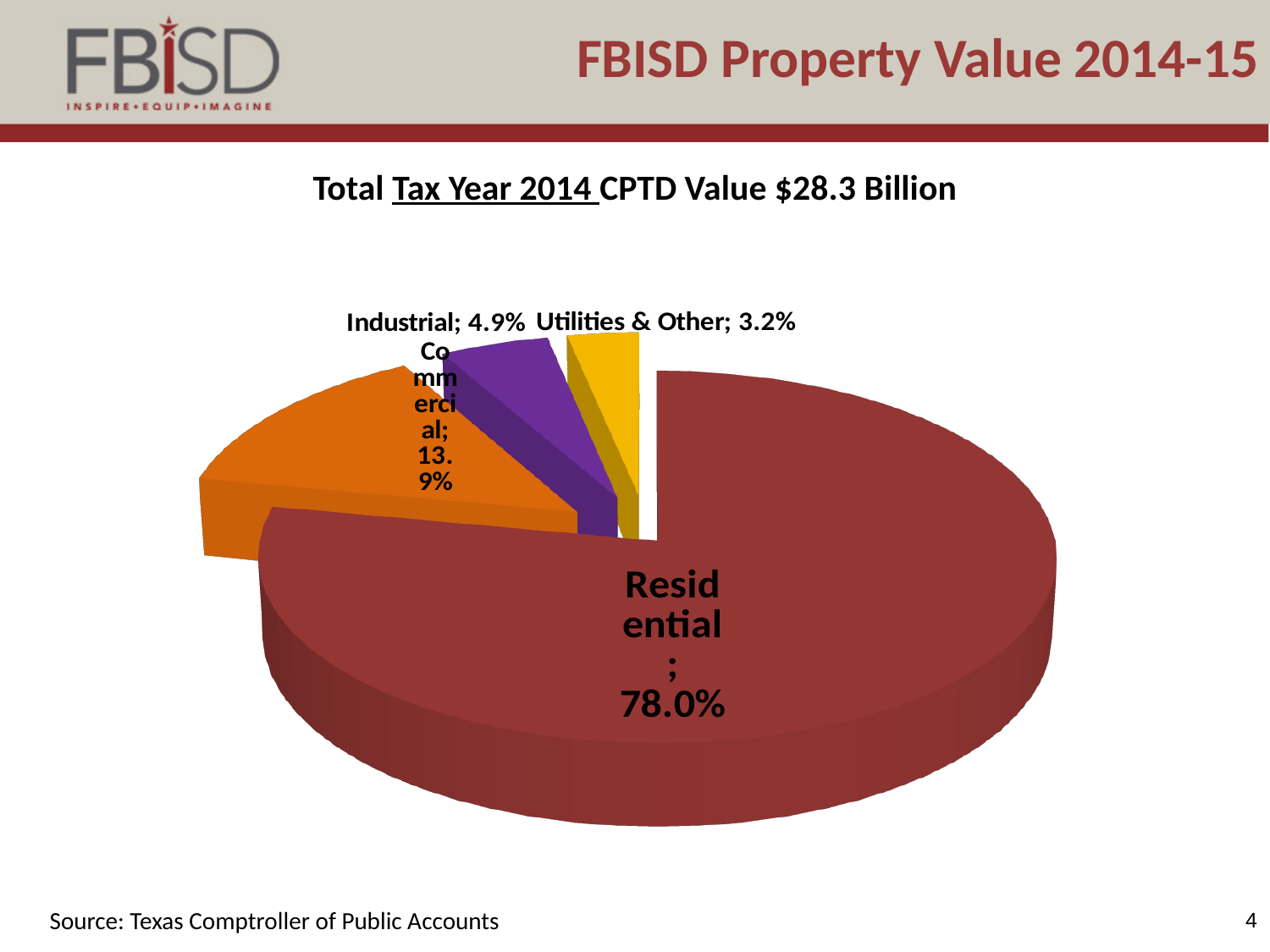
What share of the pie does Utilities & Other represent? 3.2% Which is larger, the Commercial slice or the Industrial slice? Commercial What share of the pie does Industrial represent? 4.9% Which category has the smallest slice of the pie? Utilities & Other How many slices does the pie chart have? 4 What is the difference in percentage points between Industrial and Utilities & Other? 1.7 What kind of chart is shown on the slide? pie chart What share of the pie does Commercial represent? 13.9% What is the difference in percentage points between Residential and Commercial? 64.1 What total CPTD value is stated above the chart? $28.3 Billion Which category has the largest slice of the pie? Residential